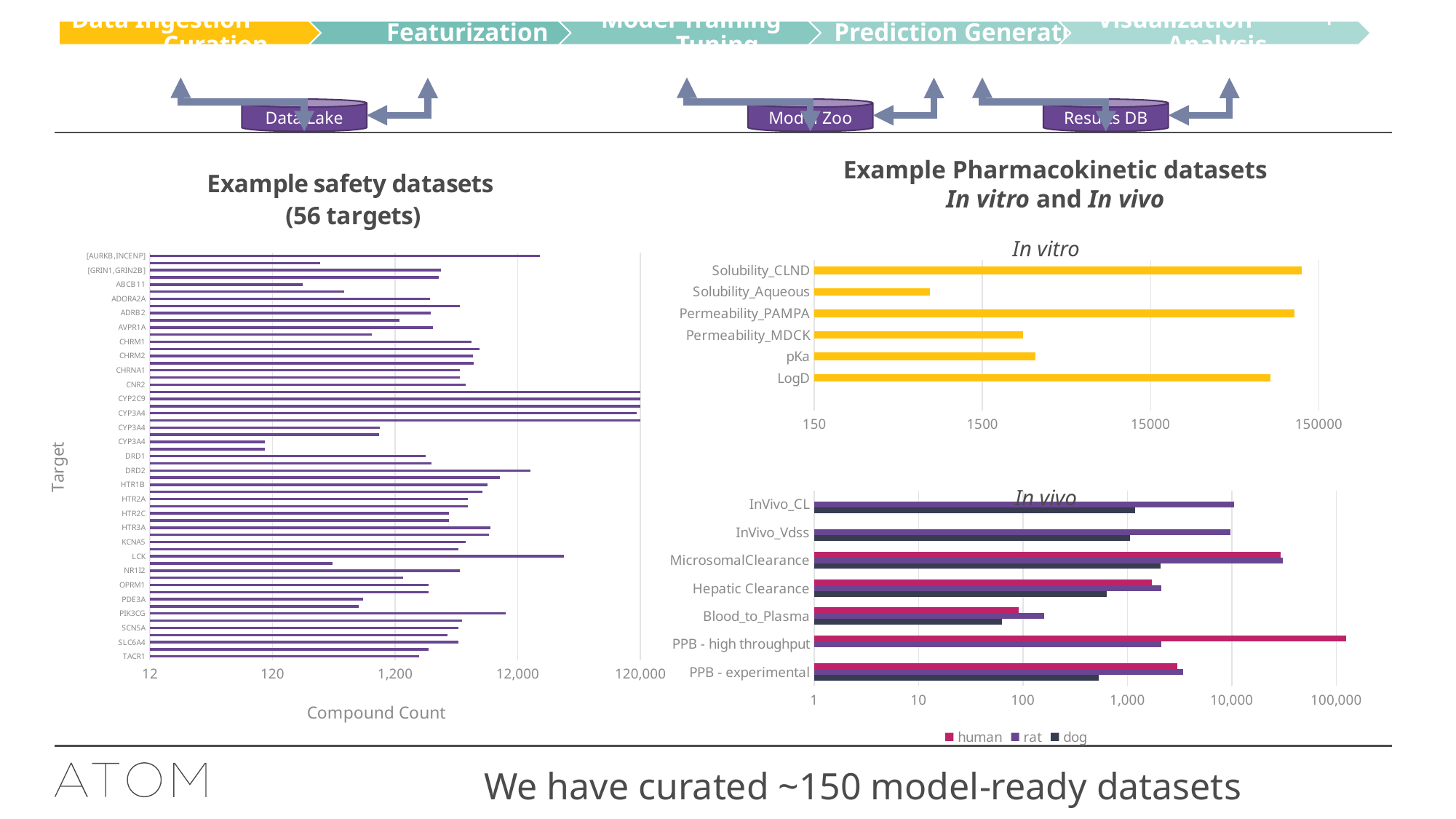
What is the x-axis title of the 'Example safety datasets' chart? Compound Count In the 'In vivo' chart, for PPB - high throughput, which is larger: the human value or the rat value? human In the 'In vitro' chart, is the value for Solubility_Aqueous greater or less than 1500? less How many categories does the 'In vitro' chart show? 6 In the 'In vitro' chart, is the value for LogD greater or less than 15000? greater In the 'In vivo' chart, which category has the highest value for the human series? PPB - high throughput In the 'In vivo' chart, is the dog value for Blood_to_Plasma greater or less than 100? less How many series does the legend of the 'In vivo' chart list? 3 How many categories does the 'In vivo' chart show? 7 In the 'In vitro' chart, which category has the lowest value? Solubility_Aqueous What kind of chart is the 'In vitro' chart? bar chart